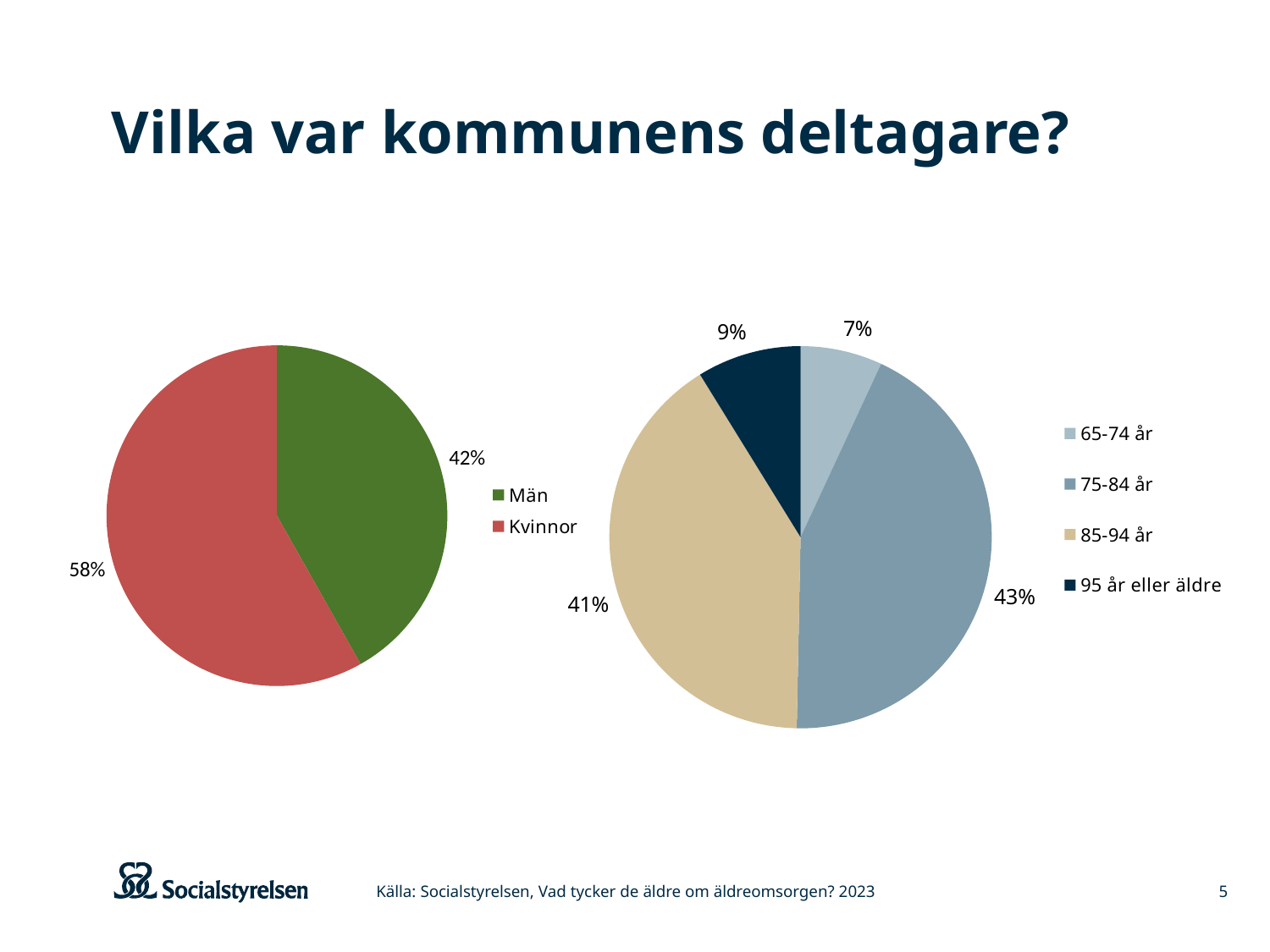
What type of chart is the left chart on the slide? Pie chart In the left pie chart, what share of participants are Kvinnor? 58% In the right pie chart, what share of participants are 75-84 år? 43% In the left pie chart, what is the difference in percentage points between Kvinnor and Män? 16 In the left pie chart, what share of participants are Män? 42% In the left pie chart, which group has the larger share, Män or Kvinnor? Kvinnor In the right pie chart, what is the difference in percentage points between 85-94 år and 95 år eller äldre? 32 In the right pie chart, how many age groups does the legend list? 4 In the right pie chart, what share of participants are 95 år eller äldre? 9% In the right pie chart, what share of participants are 65-74 år? 7% In the right pie chart, which age group has the largest share? 75-84 år In the right pie chart, which age group has the smallest share? 65-74 år